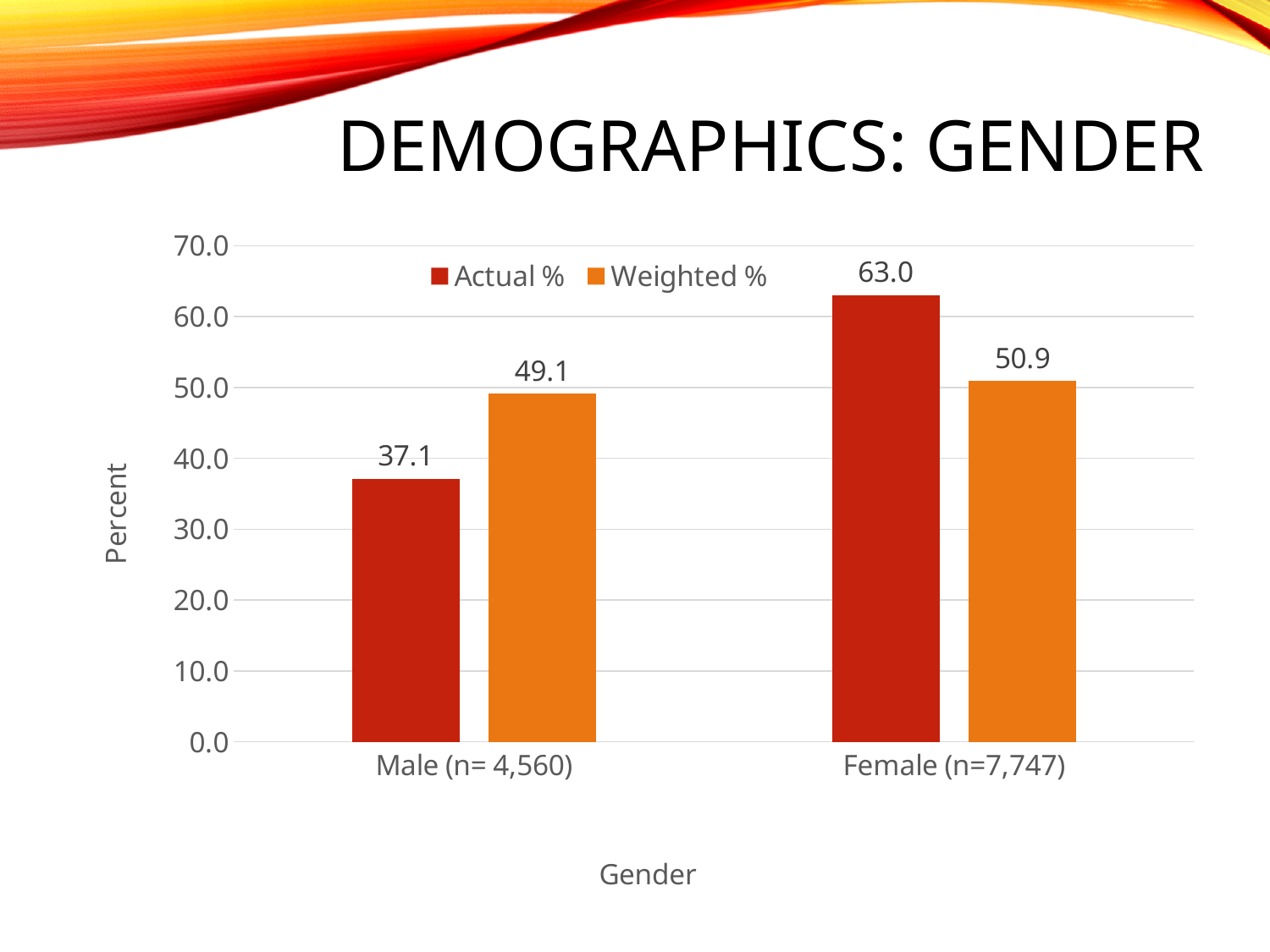
Which is larger for Female (n=7,747): the Actual % or the Weighted % value? Actual % What kind of chart is shown on the slide? bar chart Which category has the highest Actual % value? Female (n=7,747) How many series does the legend list? 2 Which category has the lowest Weighted % value? Male (n= 4,560) What is the Actual % value for Male (n= 4,560)? 37.1 What is the Weighted % value for Female (n=7,747)? 50.9 What is the difference between the Actual % and Weighted % values for Male (n= 4,560)? 12.0 What is the Weighted % value for Male (n= 4,560)? 49.1 What is the difference between the Actual % values for Female (n=7,747) and Male (n= 4,560)? 25.9 Is the Actual % value for Female (n=7,747) greater or less than 60.0? greater How many categories are shown on the x axis? 2